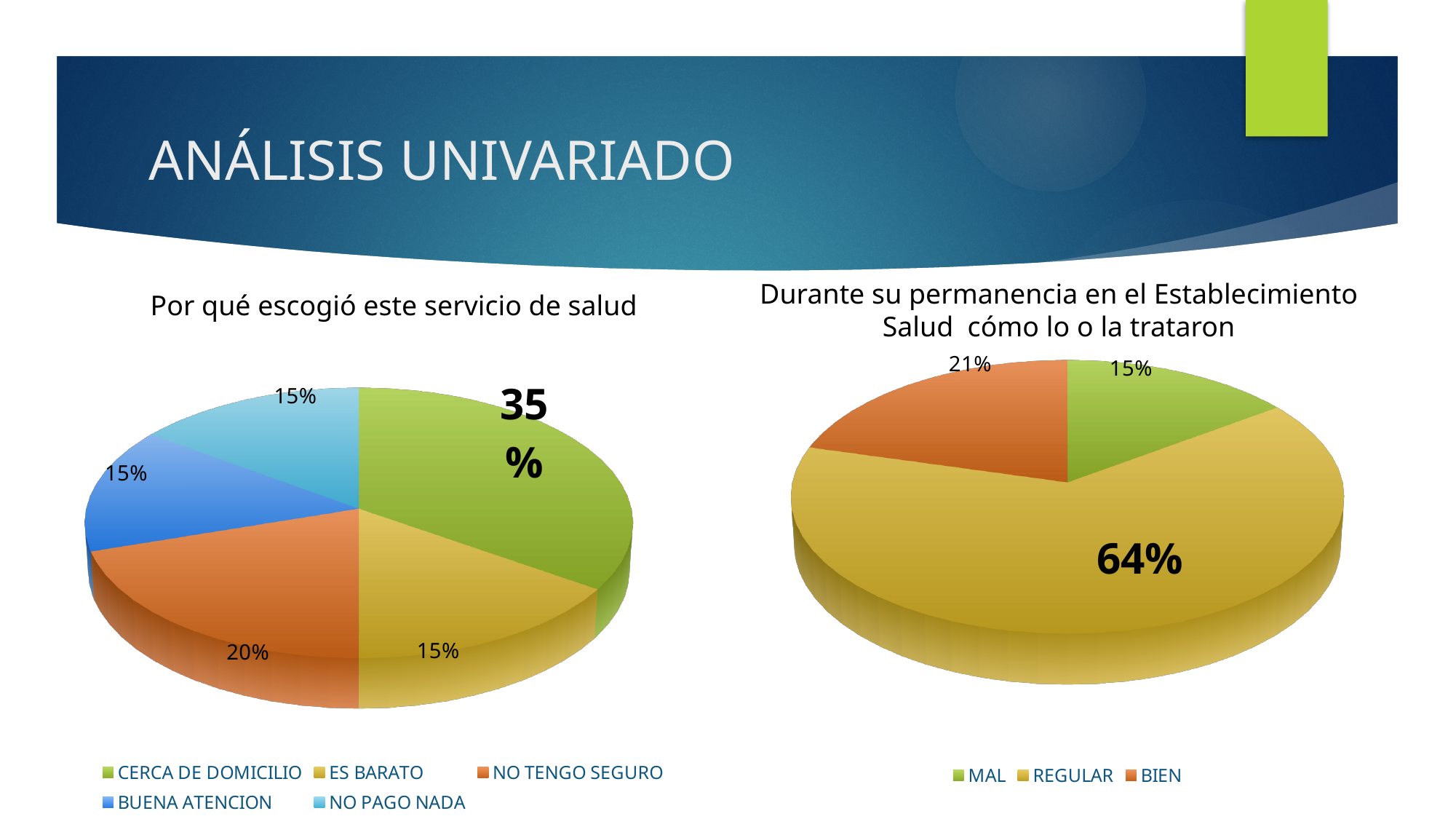
In the chart 'Durante su permanencia en el Establecimiento Salud cómo lo o la trataron', what share does REGULAR have? 64% In the chart 'Por qué escogió este servicio de salud', what is the difference between the shares of CERCA DE DOMICILIO and NO TENGO SEGURO? 15% What kind of chart is 'Por qué escogió este servicio de salud'? Pie chart In the chart 'Durante su permanencia en el Establecimiento Salud cómo lo o la trataron', what share does BIEN have? 21% In the chart 'Durante su permanencia en el Establecimiento Salud cómo lo o la trataron', how many categories does the legend list? 3 In the chart 'Por qué escogió este servicio de salud', what share does NO TENGO SEGURO have? 20% In the chart 'Por qué escogió este servicio de salud', how many categories does the legend list? 5 In the chart 'Durante su permanencia en el Establecimiento Salud cómo lo o la trataron', what is the difference between the shares of REGULAR and BIEN? 43% In the chart 'Durante su permanencia en el Establecimiento Salud cómo lo o la trataron', which category has the smallest share? MAL In the chart 'Por qué escogió este servicio de salud', what share does CERCA DE DOMICILIO have? 35% In the chart 'Por qué escogió este servicio de salud', which category has the largest share? CERCA DE DOMICILIO In the chart 'Por qué escogió este servicio de salud', which is larger: NO TENGO SEGURO or ES BARATO? NO TENGO SEGURO